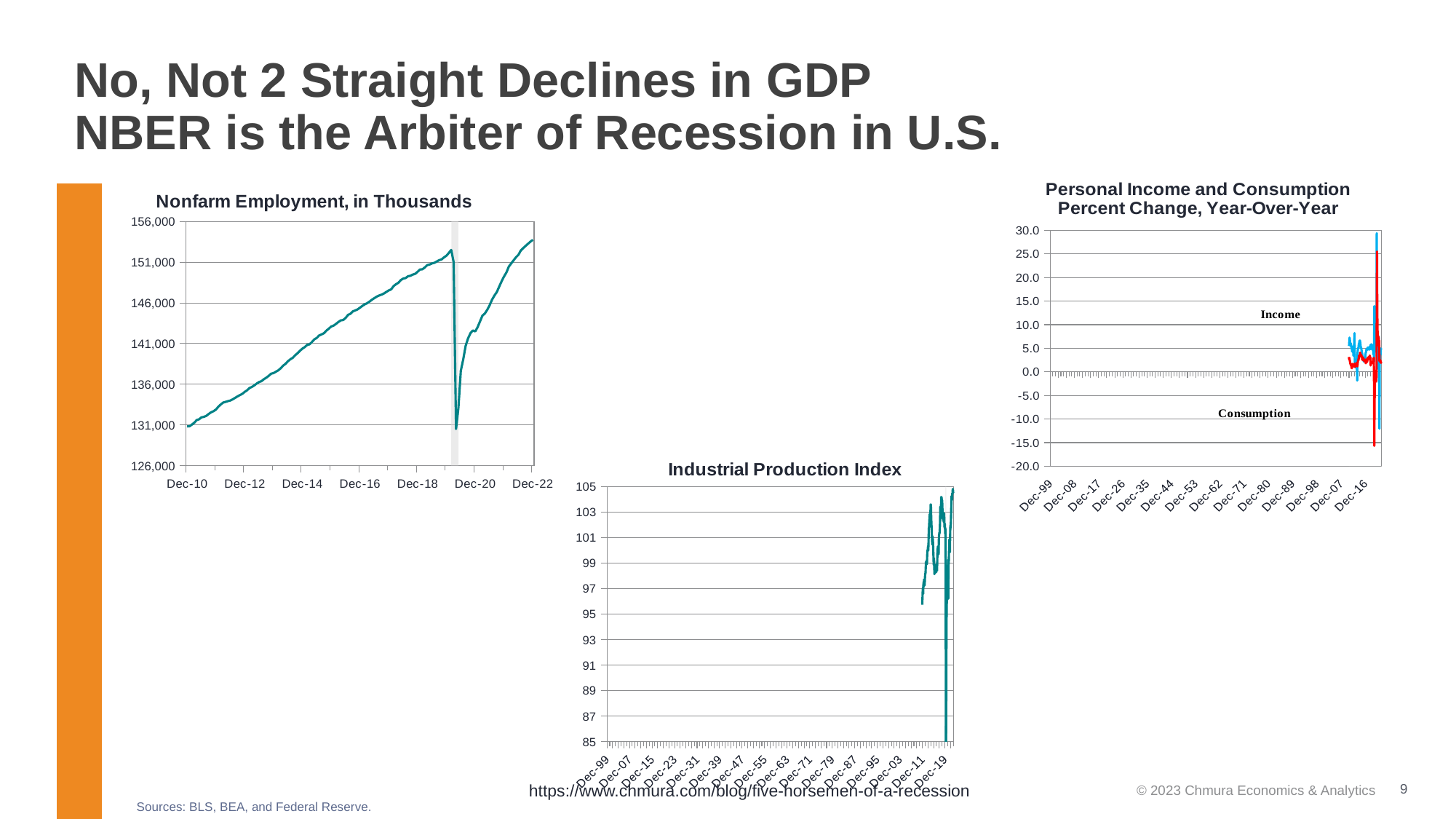
In the 'Nonfarm Employment, in Thousands' chart, is the value at Dec-22 greater or less than 151,000? greater In the 'Nonfarm Employment, in Thousands' chart, is the value at Dec-10 greater or less than 136,000? less In the 'Nonfarm Employment, in Thousands' chart, is the value at Dec-16 greater or less than 141,000? greater What kind of chart is the 'Industrial Production Index' chart? line chart What kind of chart is the 'Nonfarm Employment, in Thousands' chart? line chart How many charts are shown on the slide? 3 What are the two series labelled in the 'Personal Income and Consumption Percent Change, Year-Over-Year' chart? Income and Consumption How many series are shown in the 'Personal Income and Consumption Percent Change, Year-Over-Year' chart? 2 In the 'Nonfarm Employment, in Thousands' chart, is the value at Dec-22 higher or lower than the value at Dec-10? higher In the 'Nonfarm Employment, in Thousands' chart, does the line generally rise or fall from Dec-10 to Dec-18? rise